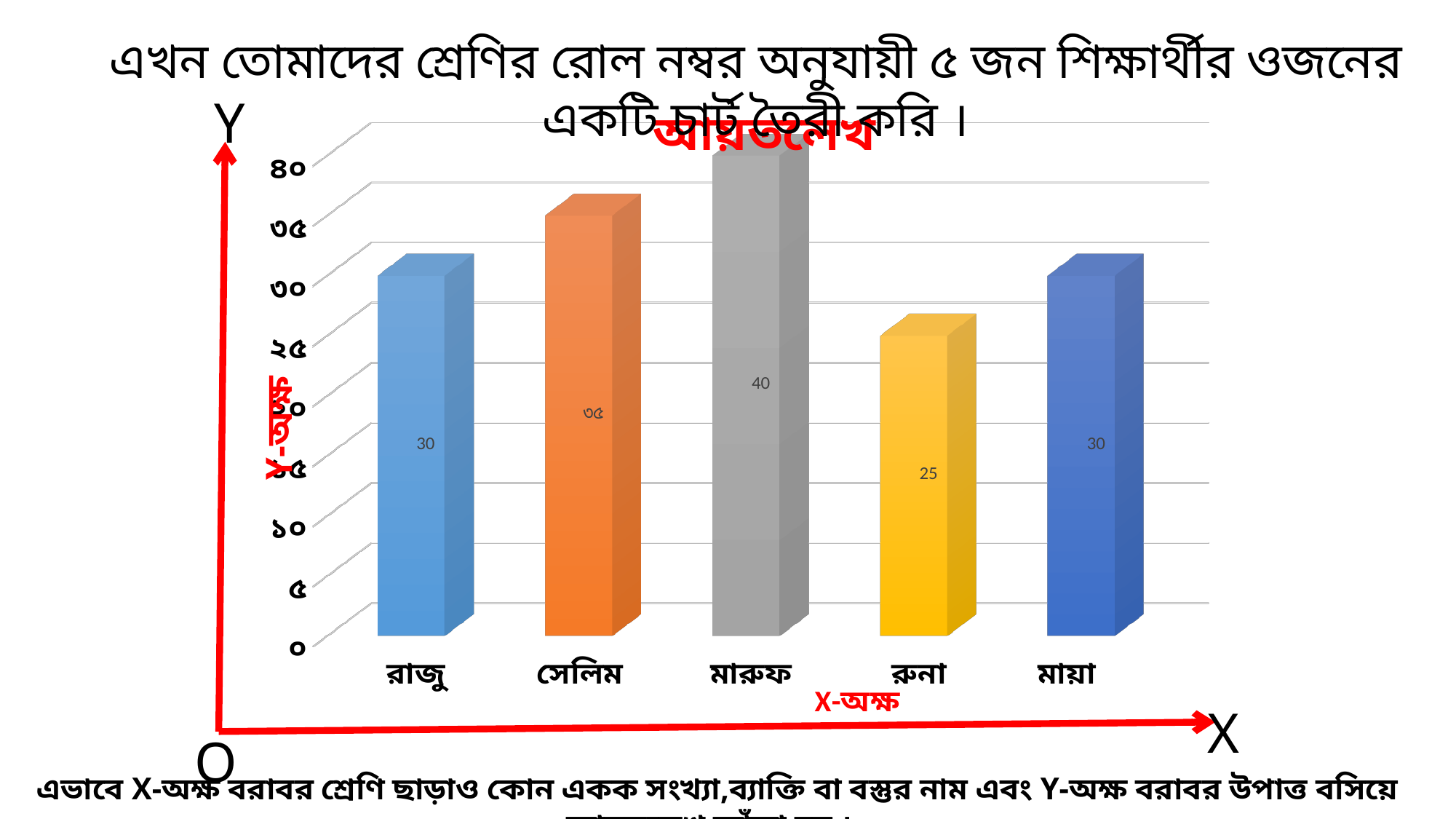
Which is larger, the value for সেলিম or the value for রাজু? সেলিম Which student has the highest bar? মারুফ What is the value shown for রুনা? 25 Which student has the lowest bar? রুনা What is the value shown for রাজু? 30 What is the data label printed on the bar for সেলিম? ৩৫ What is the value shown for মারুফ? 40 What is the value shown for মায়া? 30 What is the difference between the values for মারুফ and রুনা? 15 How many students are shown on the x axis of the chart? 5 What kind of chart is shown on the slide? bar chart Is the value for রুনা greater or less than ৩০? less